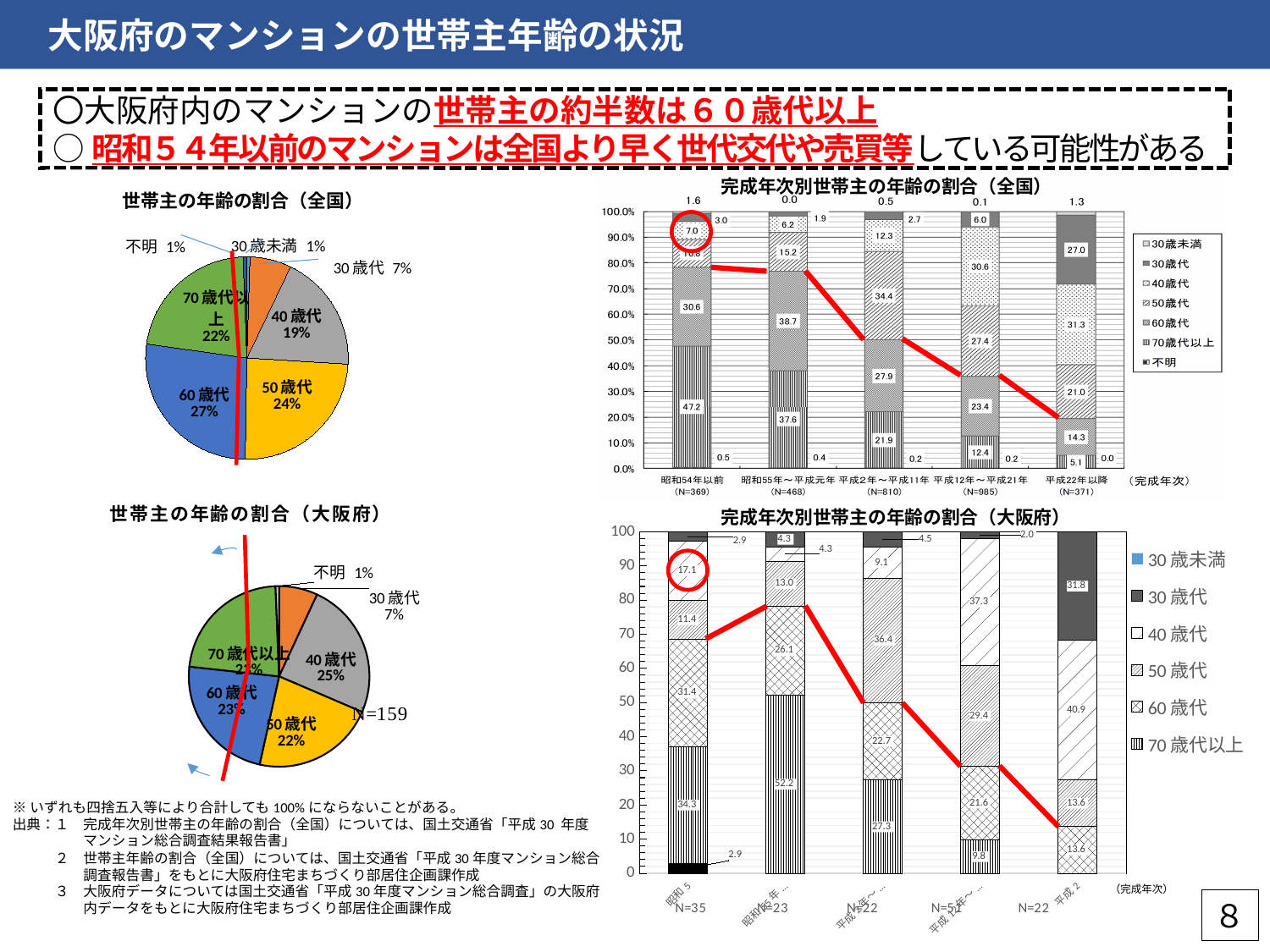
In the pie chart 世帯主の年齢の割合（大阪府）, which is larger, 60歳代 or 50歳代? 60歳代 In the chart 完成年次別世帯主の年齢の割合（全国）, how many completion-year categories are shown on the x axis? 5 In the chart 完成年次別世帯主の年齢の割合（全国）, what is the value for 70歳代以上 in the 昭和54年以前 bar? 47.2 In the pie chart 世帯主の年齢の割合（全国）, what share is 60歳代? 27% In the pie chart 世帯主の年齢の割合（全国）, what is the difference between the 50歳代 share and the 40歳代 share? 5% In the chart 完成年次別世帯主の年齢の割合（全国）, how many series does the legend list? 7 In the pie chart 世帯主の年齢の割合（大阪府）, what is the sample size N shown? N=159 In the chart 完成年次別世帯主の年齢の割合（全国）, what is the value for 40歳代 in the 平成22年以降 bar? 31.3 What kind of chart is 完成年次別世帯主の年齢の割合（大阪府）? stacked bar chart In the pie chart 世帯主の年齢の割合（全国）, which age group has the largest share? 60歳代 In the chart 完成年次別世帯主の年齢の割合（全国）, does the 70歳代以上 value rise or fall from 昭和54年以前 to 平成22年以降? fall In the pie chart 世帯主の年齢の割合（大阪府）, what share is 40歳代? 25%